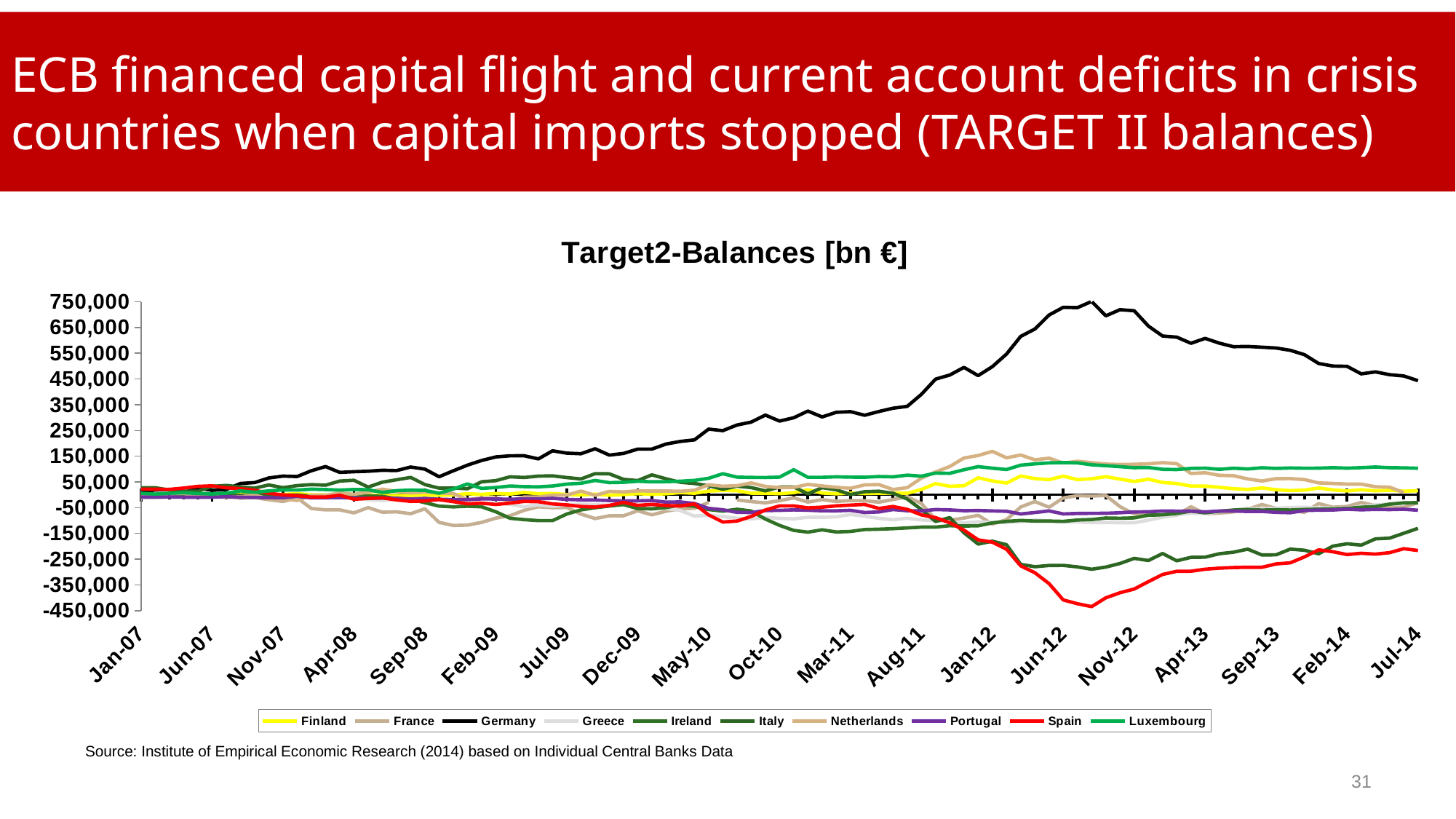
Does the Germany line rise or fall between Nov-12 and Jul-14? fall What is the title of the chart? Target2-Balances [bn €] How many series does the legend list? 10 What kind of chart is shown on the slide? line chart Which country's line reaches the lowest value on the chart? Spain Does the Germany line rise or fall between Jan-07 and Jun-12? rise Is the lowest value of the Spain line greater or less than -350,000? less At Jul-14, which is larger: the value for Germany or the value for Spain? Germany Which country's line reaches the highest value on the chart? Germany What colour is the line for Spain? red Is the value for Germany at Jul-14 greater or less than 350,000? greater Is the peak value of the Germany line greater or less than 650,000? greater